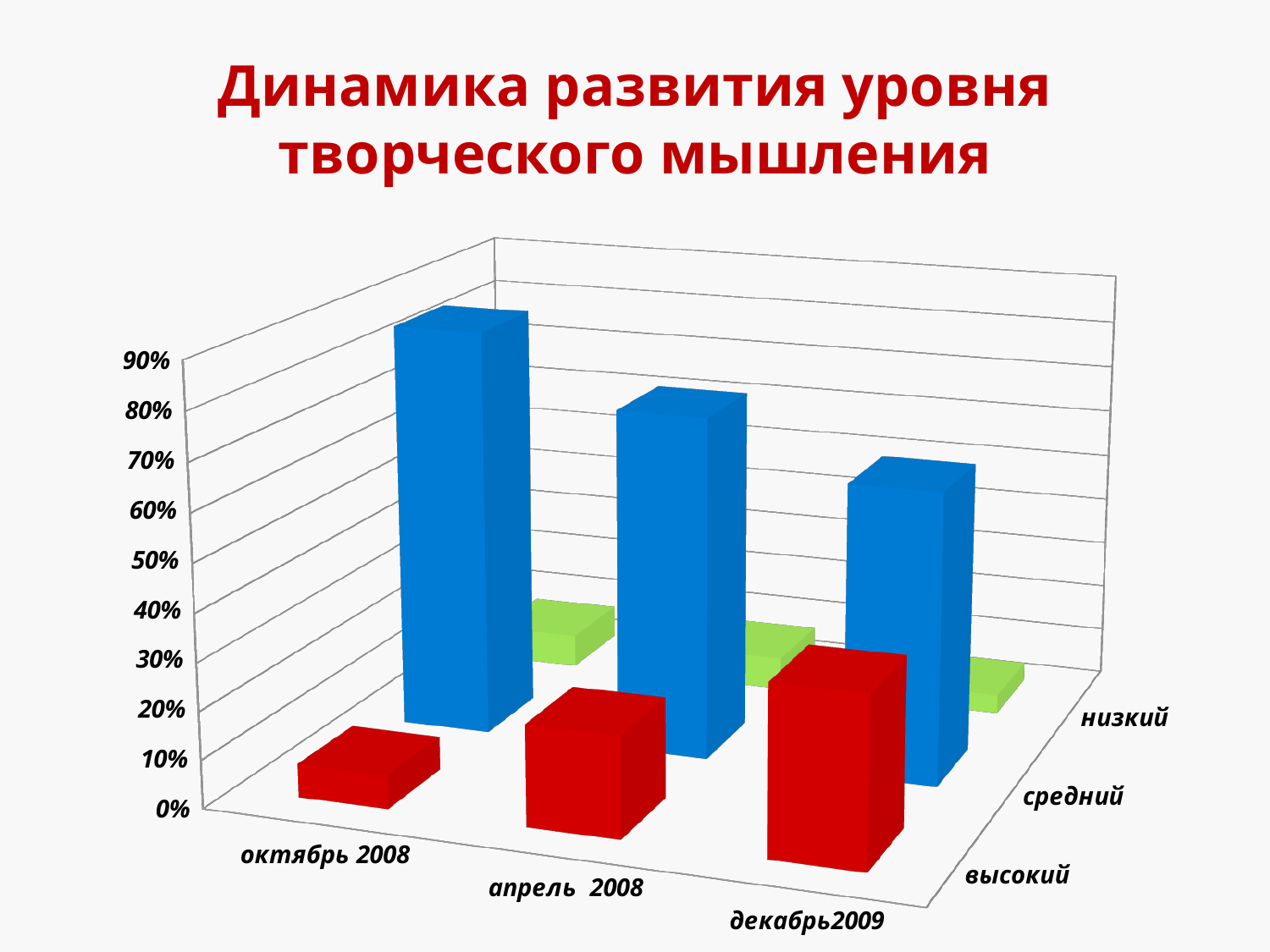
What is the title of the chart? Динамика развития уровня творческого мышления For which period is the 'высокий' level highest? декабрь2009 In октябрь 2008, which is larger: the 'средний' level or the 'высокий' level? средний How many time periods are shown along the x axis? 3 How many levels (series) are plotted in the chart? 3 Does the 'высокий' level rise or fall from октябрь 2008 to декабрь2009? rise What kind of chart is shown on the slide? bar chart For which period is the 'средний' level highest? октябрь 2008 Is the 'средний' value for октябрь 2008 greater or less than 50%? greater Which colour are the bars for the 'средний' level? blue Does the 'средний' level rise or fall from октябрь 2008 to декабрь2009? fall For which period is the 'высокий' level lowest? октябрь 2008